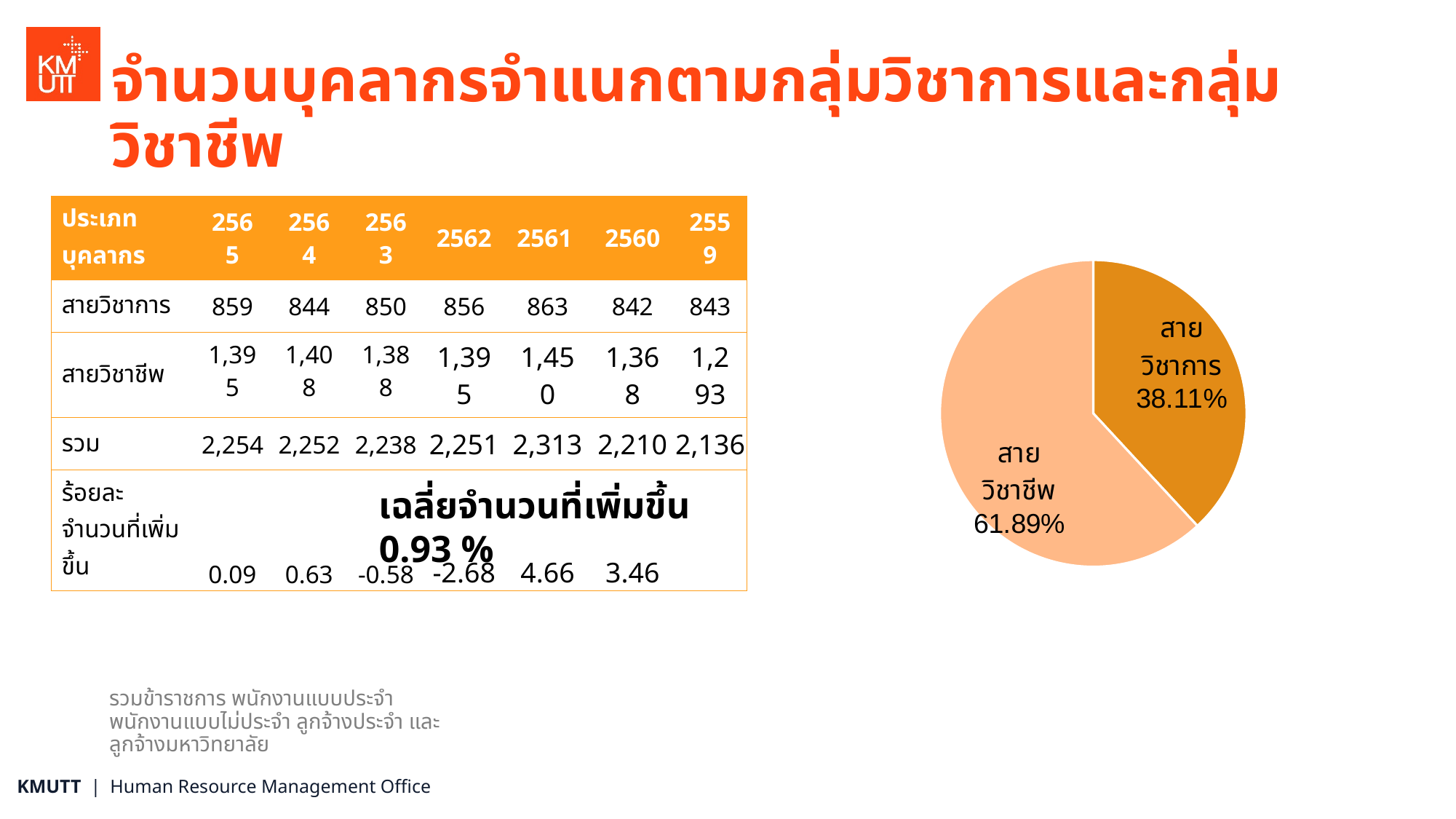
What kind of chart is shown on the right side of the slide? pie chart Which slice of the pie chart is the largest? สายวิชาชีพ In the pie chart, which is larger: สายวิชาการ or สายวิชาชีพ? สายวิชาชีพ What is the difference in percentage points between the สายวิชาชีพ and สายวิชาการ slices of the pie chart? 23.78 How many slices does the pie chart have? 2 Which slice of the pie chart is the smallest? สายวิชาการ What share of the pie chart does สายวิชาการ represent? 38.11% What share of the pie chart does สายวิชาชีพ represent? 61.89% Is the share of สายวิชาการ in the pie chart greater or less than 50%? less Which slice of the pie chart is drawn in the darker orange colour? สายวิชาการ